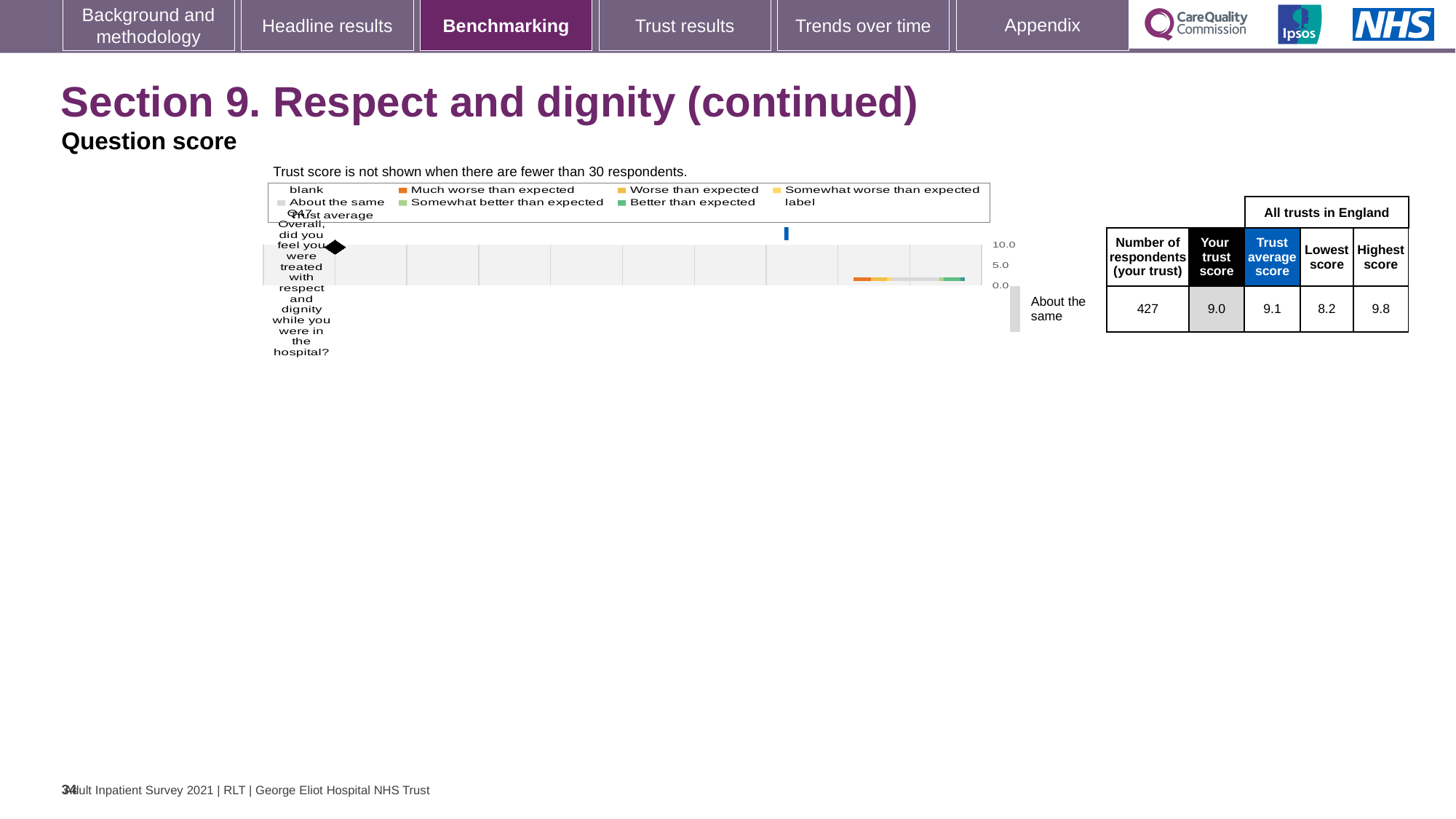
Which question is plotted on the chart? Q47 How many respondents from the trust answered Q47? 427 Which benchmarking category is the trust's Q47 score placed in? About the same What is the highest score among all trusts in England for Q47? 9.8 What is the trust average score for Q47? 9.1 What is the lowest score among all trusts in England for Q47? 8.2 What kind of chart is shown on the slide? bar chart How many survey questions are plotted on the chart? 1 What is the trust score for Q47 (Overall, did you feel you were treated with respect and dignity while you were in the hospital?)? 9.0 Which is larger for Q47, the trust score or the trust average score? Trust average score Is the trust score for Q47 greater or less than 5.0? greater What is the difference between the highest score and the lowest score for Q47? 1.6